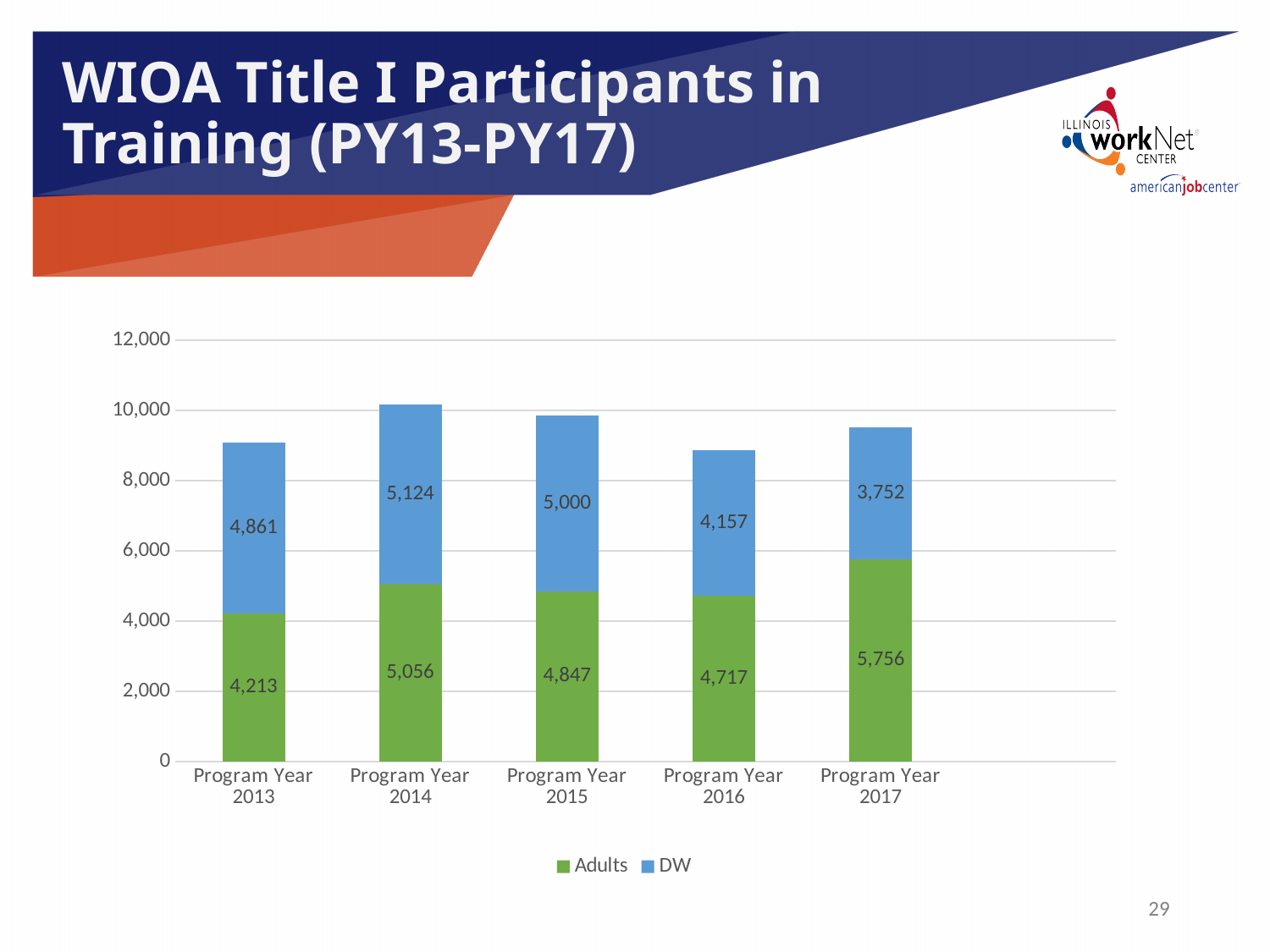
How many series does the legend list? 2 Which is larger for Program Year 2017, the Adults value or the DW value? Adults Is the total stacked bar for Program Year 2014 greater or less than 10,000? greater How many program years are shown on the x axis? 5 What is the DW value for Program Year 2016? 4,157 What is the difference between the DW value and the Adults value for Program Year 2014? 68 Which program year has the lowest DW value? Program Year 2017 Which colour represents the DW series in the chart? Blue Which program year has the highest Adults value? Program Year 2017 What is the total of the stacked bar for Program Year 2016? 8,874 What is the Adults value for Program Year 2013? 4,213 What kind of chart is shown on the slide? Stacked bar chart